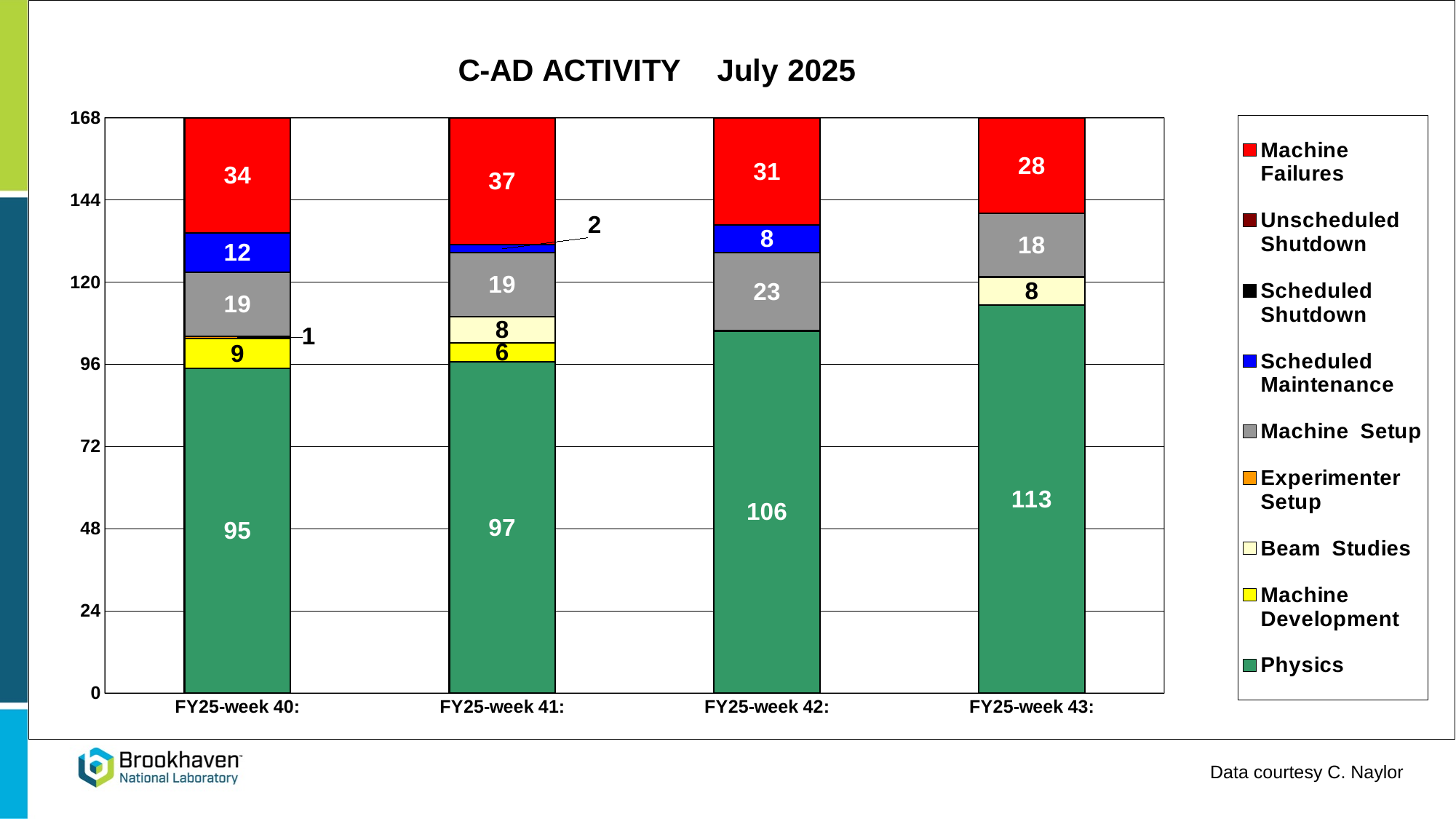
How many series does the legend list? 9 Which week has the highest Physics value? FY25-week 43 Which week has the larger Machine Setup value, FY25-week 42 or FY25-week 43? FY25-week 42 What is the Scheduled Maintenance value for FY25-week 42? 8 What is the difference between the Physics values for FY25-week 42 and FY25-week 40? 11 Which week has the lowest Machine Failures value? FY25-week 43 How many weeks are shown on the x axis? 4 What is the Machine Setup value for FY25-week 40? 19 Does the Physics value rise or fall from FY25-week 40 to FY25-week 43? rise What is the Physics value for FY25-week 43? 113 What is the difference between the Machine Failures values for FY25-week 41 and FY25-week 43? 9 What is the Machine Failures value for FY25-week 41? 37